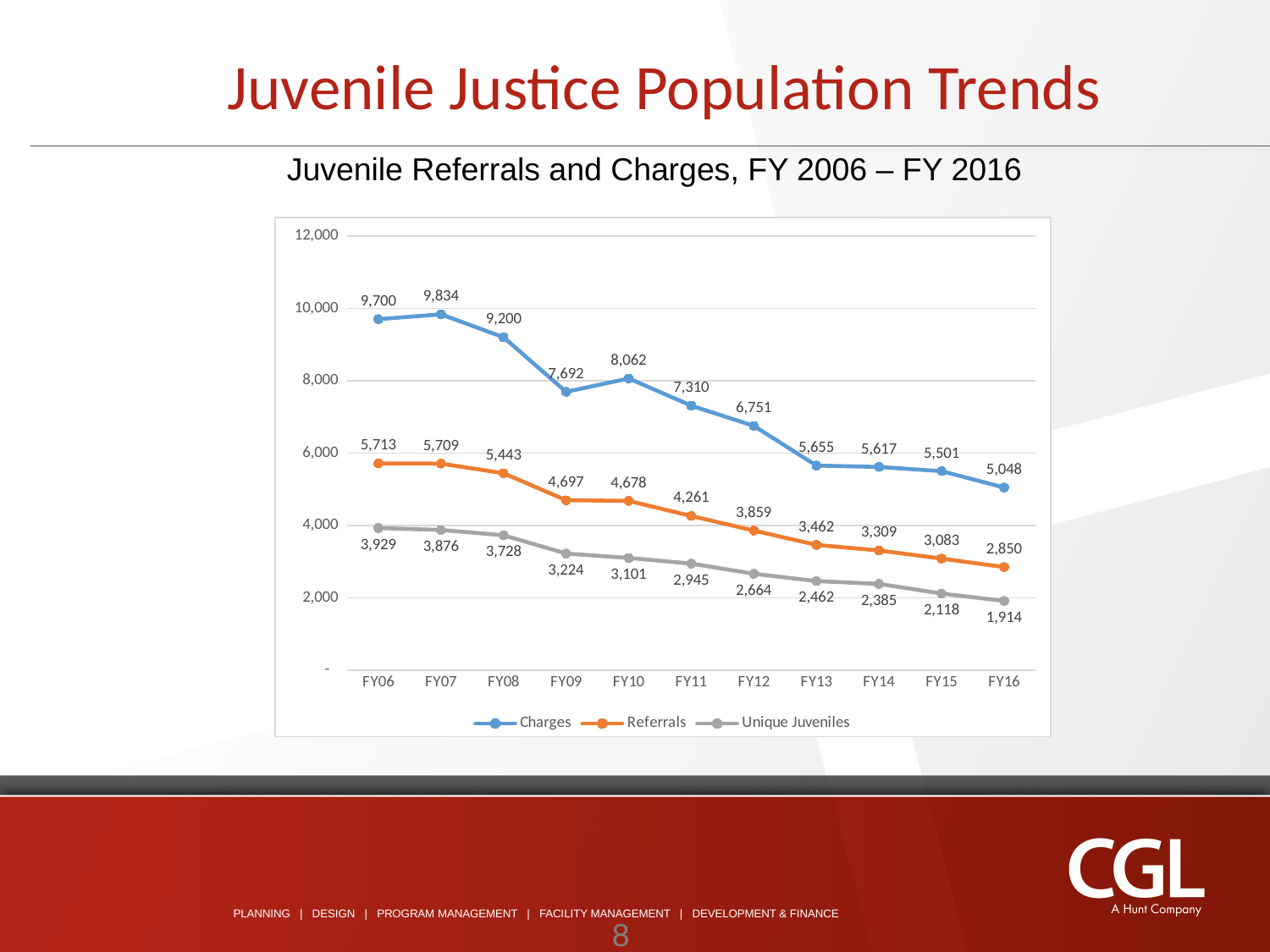
What is the difference between Charges and Referrals in FY06? 3,987 Do the Referrals values rise or fall from FY06 to FY16? Fall What is the value for Charges in FY07? 9,834 What kind of chart is shown on the slide? Line chart What is the value for Unique Juveniles in FY10? 3,101 How many fiscal years are shown on the x axis? 11 Is the value for Charges in FY12 greater or less than 6,000? greater In which fiscal year is the Unique Juveniles series lowest? FY16 Which is larger in FY13: Referrals or Unique Juveniles? Referrals What is the value for Referrals in FY16? 2,850 How many series does the legend list? 3 In which fiscal year is the Charges series highest? FY07